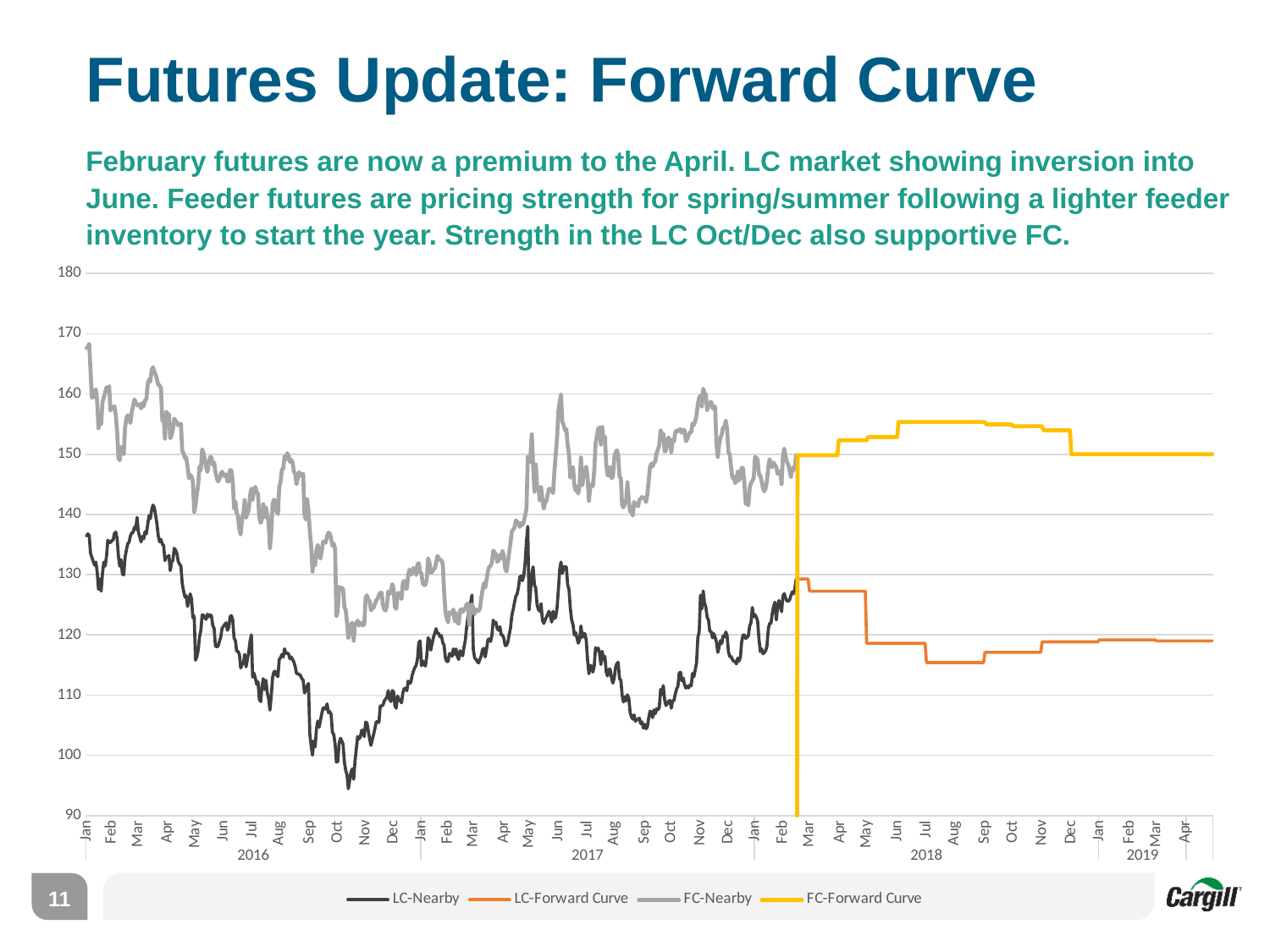
Which series is drawn in yellow? FC-Forward Curve Is the value of the FC-Forward Curve in Jul 2018 greater or less than 150? greater Which series is drawn in orange? LC-Forward Curve Is the value of the LC-Forward Curve in Aug 2018 greater or less than 120? less Is the lowest value of LC-Nearby in Oct 2016 greater or less than 100? less Does the LC-Forward Curve rise or fall overall from Mar 2018 to Apr 2019? fall What kind of chart is shown on the slide? Line chart Which series reaches the highest value on the chart? FC-Nearby How many series does the legend list? 4 How many years are labelled along the x axis? 4 Which is higher in Jul 2018, the FC-Forward Curve or the LC-Forward Curve? FC-Forward Curve